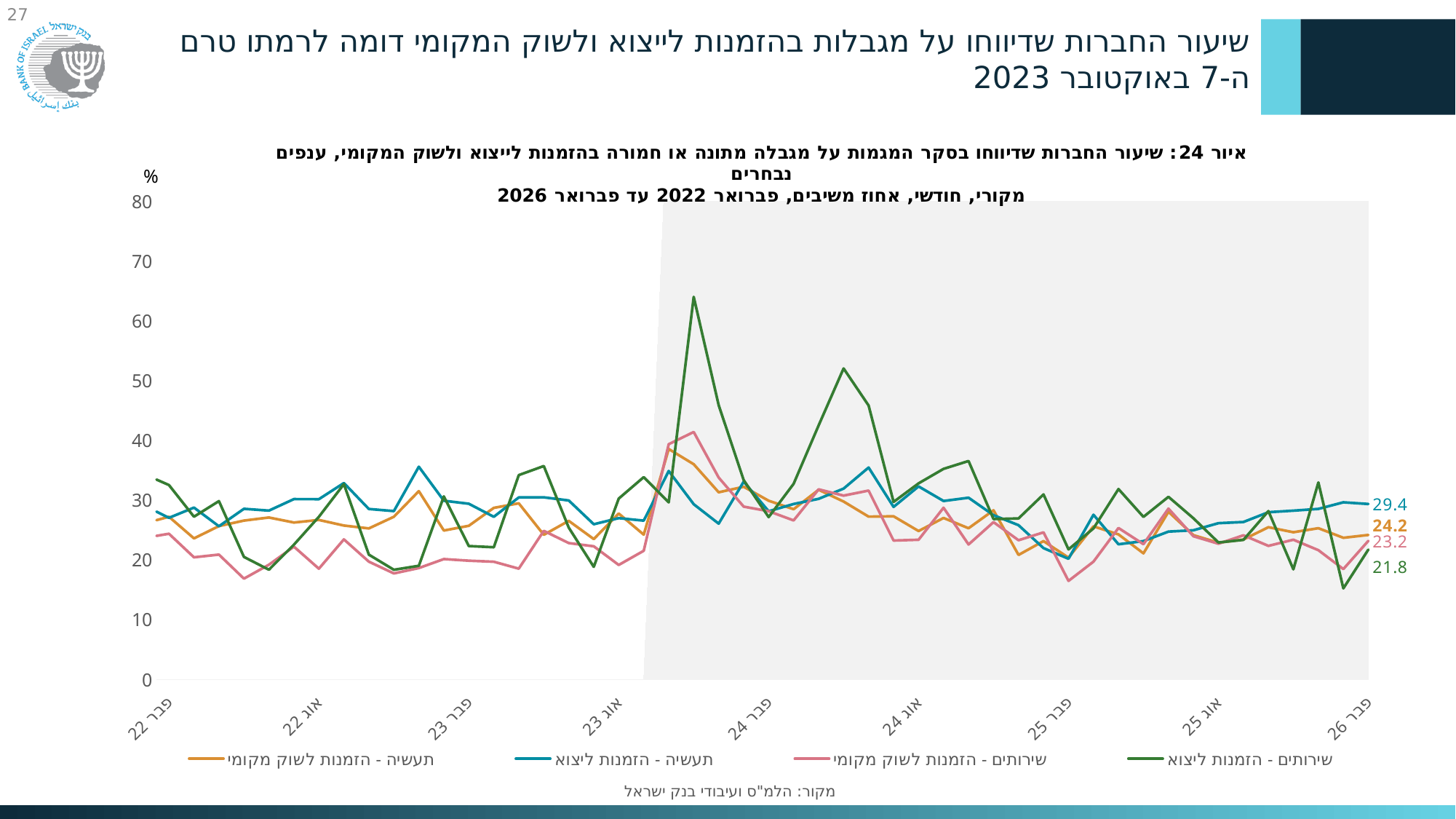
What is the value labelled at the end of the series שירותים - הזמנות לייצוא (פבר 26)? 21.8 At the last point (פבר 26), which is larger: תעשיה - הזמנות לשוק מקומי or שירותים - הזמנות לשוק מקומי? תעשיה - הזמנות לשוק מקומי What is the value labelled at the end of the series שירותים - הזמנות לשוק מקומי (פבר 26)? 23.2 What is the difference between the end-point values of תעשיה - הזמנות לייצוא and שירותים - הזמנות לייצוא? 7.6 Is the highest peak reached by the שירותים - הזמנות לייצוא series greater or less than 60? greater Which series has the lowest value at the last point (פבר 26)? שירותים - הזמנות לייצוא Which series has the highest value at the last point (פבר 26)? תעשיה - הזמנות לייצוא What is the value labelled at the end of the series תעשיה - הזמנות לייצוא (פבר 26)? 29.4 What source is cited below the chart? הלמ"ס ועיבודי בנק ישראל How many series does the legend list? 4 What kind of chart is shown on the slide? line chart What is the value labelled at the end of the series תעשיה - הזמנות לשוק מקומי (פבר 26)? 24.2